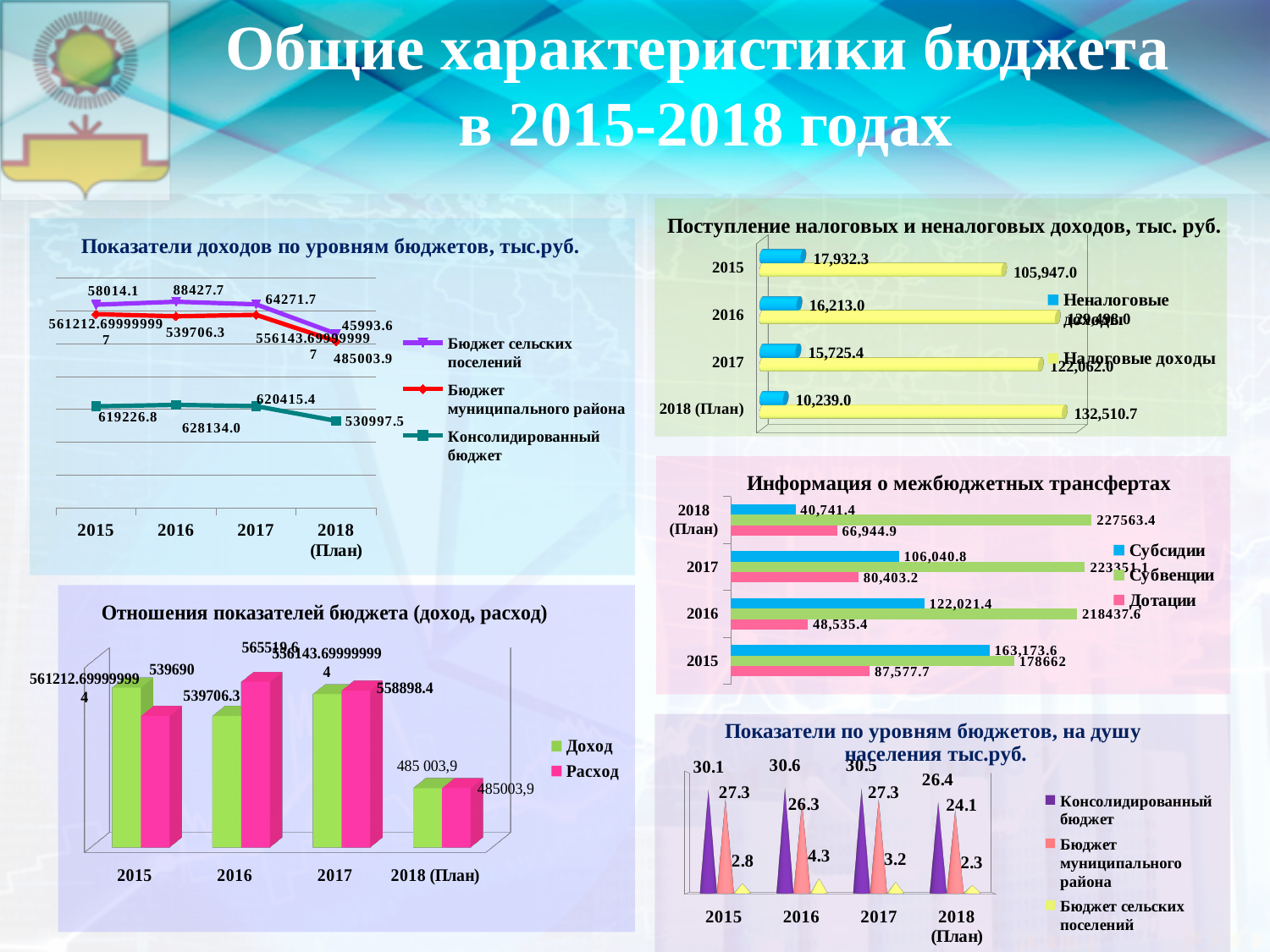
What type of chart is 'Отношения показателей бюджета (доход, расход)'? bar chart In the chart 'Информация о межбюджетных трансфертах', which is larger for 2016: Субсидии or Дотации? Субсидии In the chart 'Показатели доходов по уровням бюджетов, тыс.руб.', which year has the highest value for Бюджет сельских поселений? 2016 In the chart 'Отношения показателей бюджета (доход, расход)', what is the value of Расход for 2016? 565519.6 In the chart 'Поступление налоговых и неналоговых доходов, тыс. руб.', which year has the highest Налоговые доходы? 2018 (План) In the chart 'Показатели по уровням бюджетов, на душу населения тыс.руб.', what is the difference between Консолидированный бюджет and Бюджет сельских поселений for 2015? 27.3 In the chart 'Информация о межбюджетных трансфертах', what is the value of Субвенции for 2017? 223351.1 In the chart 'Поступление налоговых и неналоговых доходов, тыс. руб.', which year has the lowest Неналоговые доходы? 2018 (План) In the chart 'Показатели доходов по уровням бюджетов, тыс.руб.', what is the value of Консолидированный бюджет for 2016? 628134.0 In the chart 'Информация о межбюджетных трансфертах', how many series does the legend list? 3 In the chart 'Поступление налоговых и неналоговых доходов, тыс. руб.', what is the value of Неналоговые доходы for 2015? 17,932.3 In the chart 'Показатели по уровням бюджетов, на душу населения тыс.руб.', what is the value of Бюджет муниципального района for 2018 (План)? 24.1